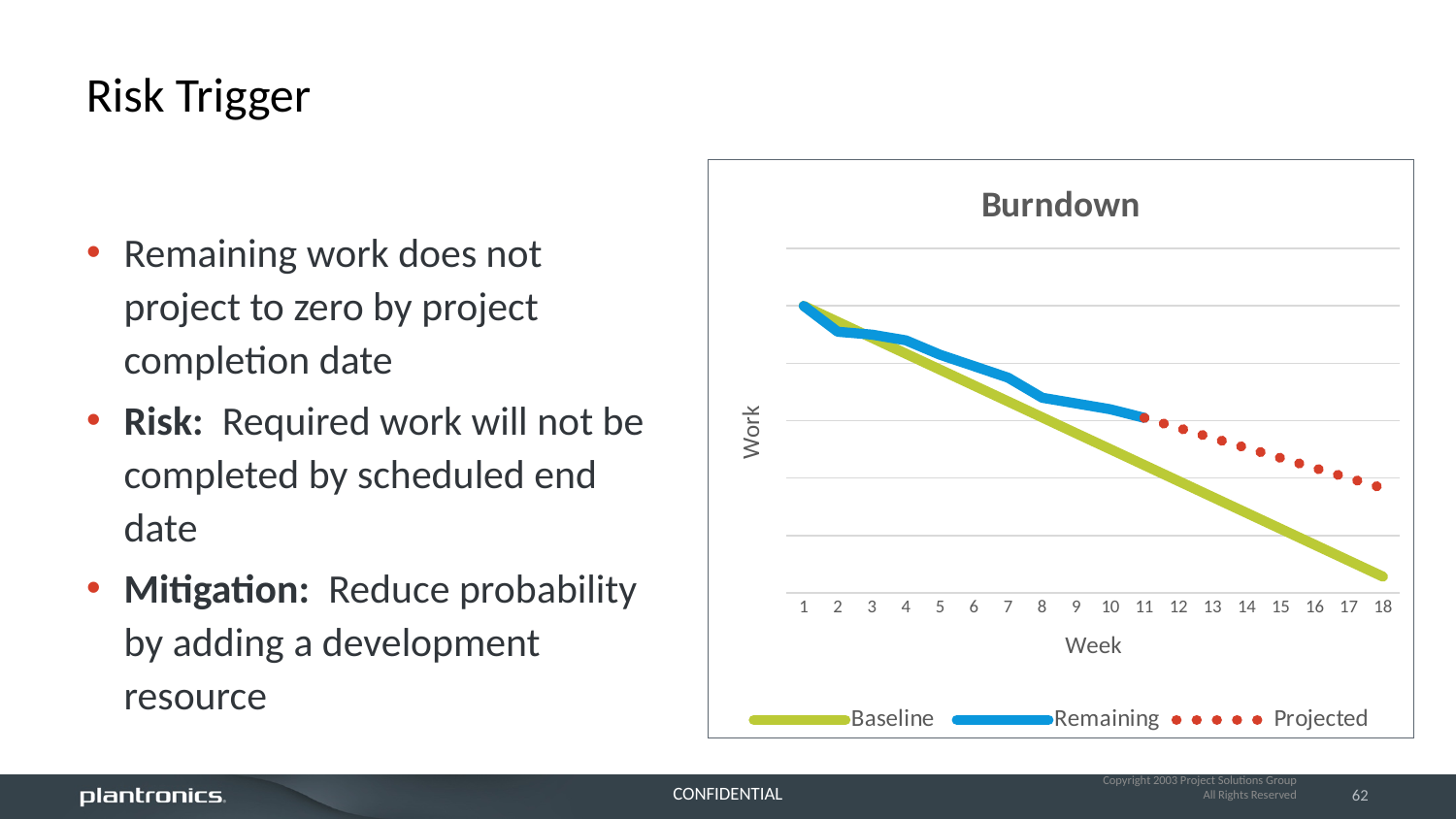
Does the Baseline series rise or fall as the week number increases? fall At which week does the Baseline series reach its lowest value? 18 At which week does the Remaining series have its highest value? 1 What kind of chart is the Burndown chart? line chart What is the title of the chart? Burndown At week 11, which series has the higher value, Baseline or Remaining? Remaining How many weeks are shown on the x axis of the Burndown chart? 18 What are the series names listed in the legend of the Burndown chart? Baseline, Remaining, Projected Does the Remaining series rise or fall from week 1 to week 11? fall How many series does the legend of the Burndown chart list? 3 At week 18, which series has the higher value, Baseline or Projected? Projected What is the label of the x axis of the Burndown chart? Week